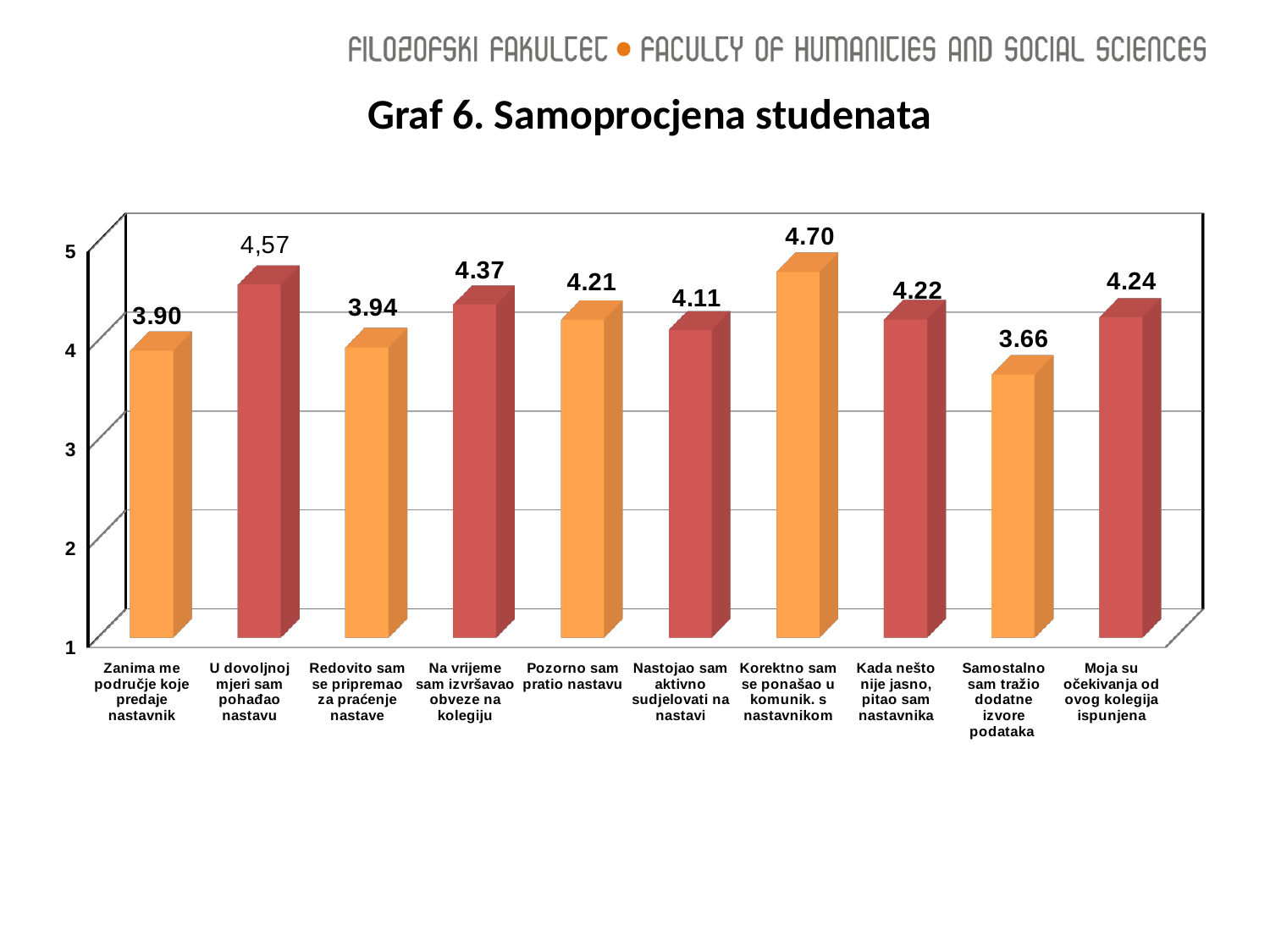
What is the value for "U dovoljnoj mjeri sam pohađao nastavu"? 4,57 How many categories are shown in the chart? 10 What is the value for "Korektno sam se ponašao u komunik. s nastavnikom"? 4.70 What is the value for "Samostalno sam tražio dodatne izvore podataka"? 3.66 Which category has the highest value? Korektno sam se ponašao u komunik. s nastavnikom Which is larger: the value for "Pozorno sam pratio nastavu" or the value for "Nastojao sam aktivno sudjelovati na nastavi"? Pozorno sam pratio nastavu What is the difference between the values for "Korektno sam se ponašao u komunik. s nastavnikom" and "Samostalno sam tražio dodatne izvore podataka"? 1.04 Is the value for "Moja su očekivanja od ovog kolegija ispunjena" greater or less than 4? greater Which category has the lowest value? Samostalno sam tražio dodatne izvore podataka What is the difference between the values for "Na vrijeme sam izvršavao obveze na kolegiju" and "Redovito sam se pripremao za praćenje nastave"? 0.43 What is the value for "Zanima me područje koje predaje nastavnik"? 3.90 What type of chart is shown on the slide? Bar chart